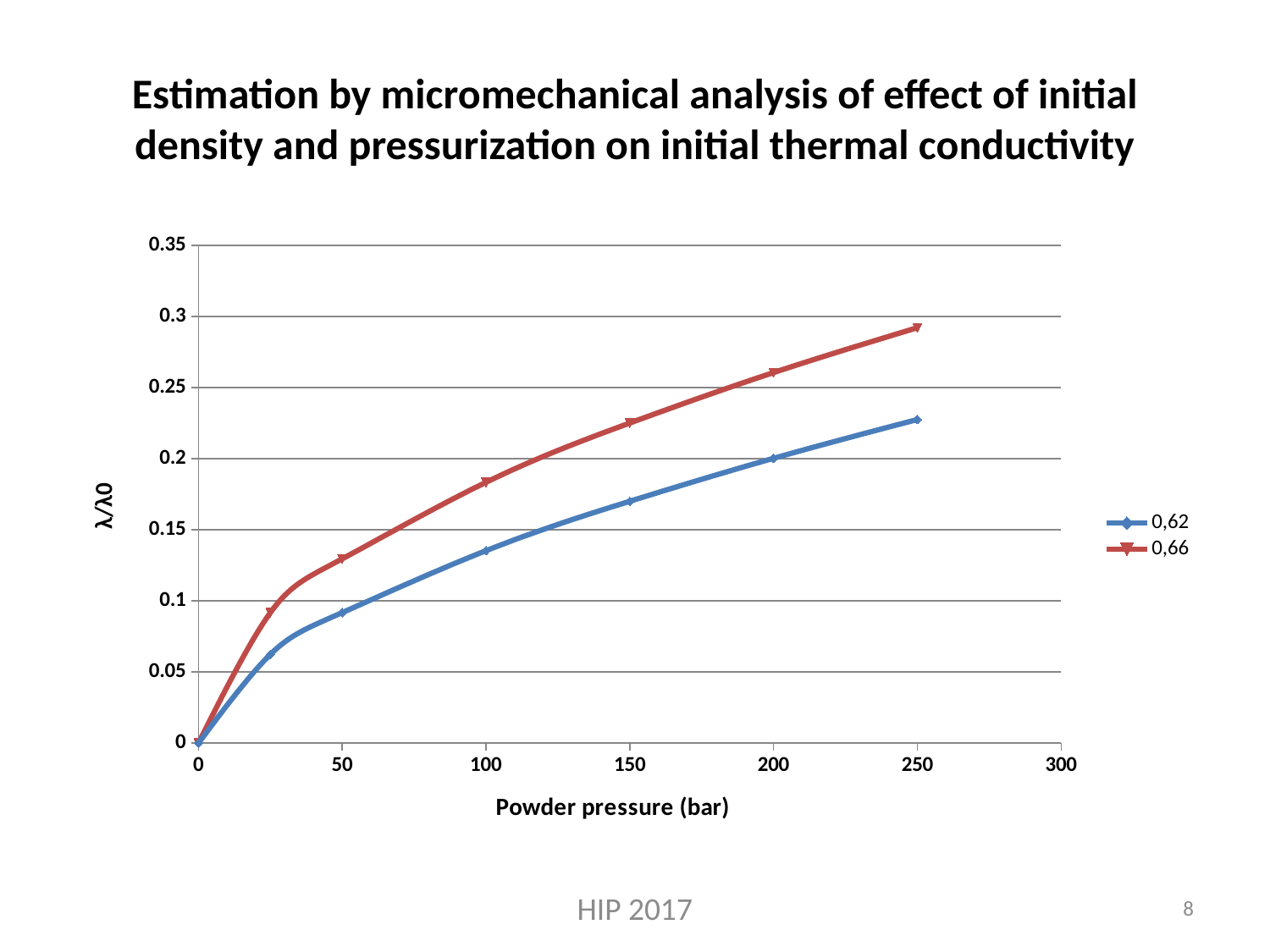
Is the value of the 0,62 series at 50 bar greater or less than 0.1? less What is the value of both series at a powder pressure of 0 bar? 0 What is the title of the x axis? Powder pressure (bar) Is the value of the 0,66 series at 100 bar greater or less than 0.15? greater Is the value of the 0,62 series at 100 bar greater or less than 0.15? less Which series has the higher value at 250 bar, 0,62 or 0,66? 0,66 Do the values of the 0,66 series rise or fall as powder pressure increases? rise What are the two series named in the legend? 0,62 and 0,66 How many series does the legend list? 2 What kind of chart is shown on the slide? line chart